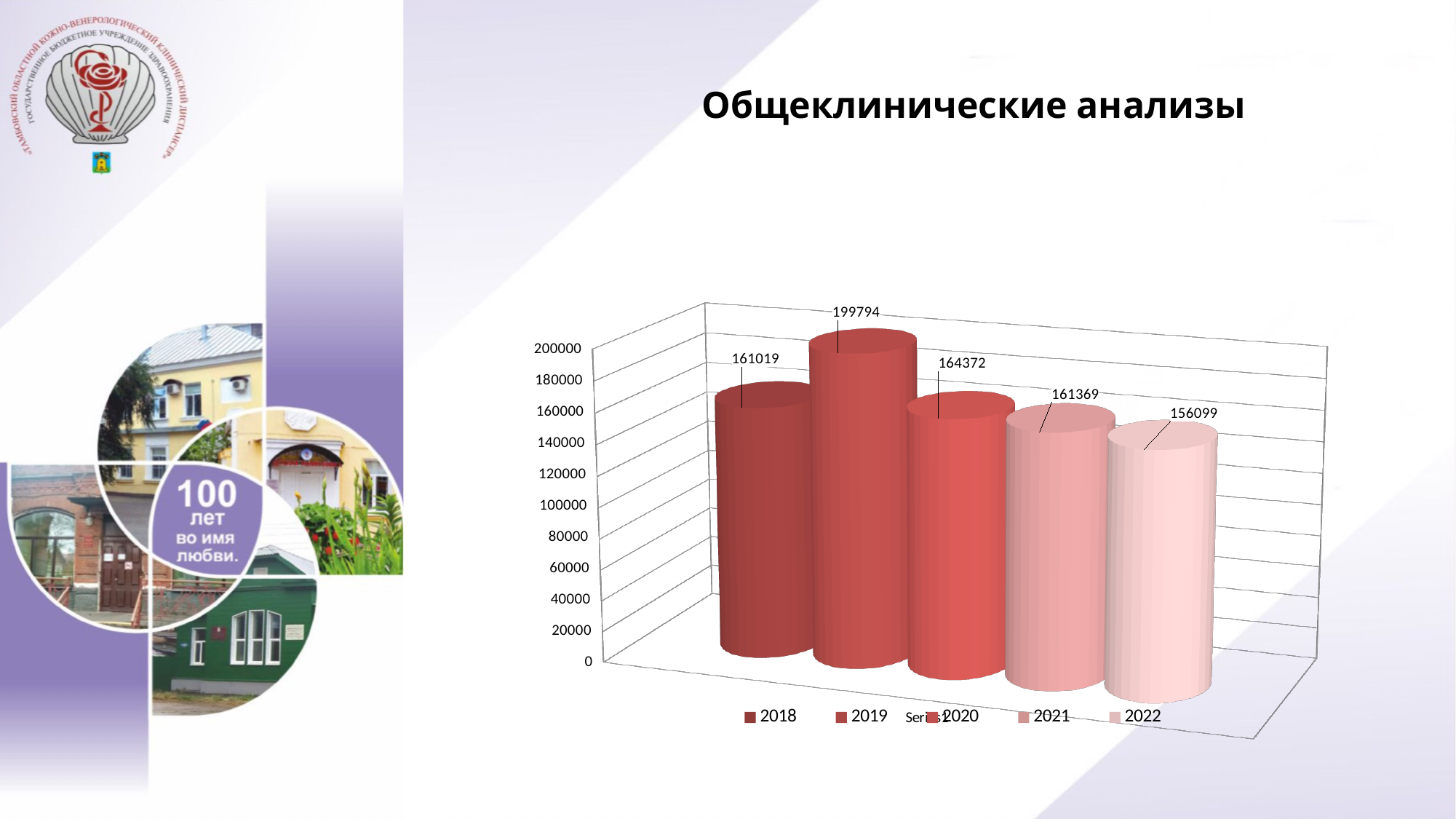
What is the value for 2019? 199794 Which year has the highest value? 2019 What kind of chart is shown on the slide? bar chart Which is larger, the value for 2020 or the value for 2022? 2020 What is the value for 2020? 164372 What is the value for 2022? 156099 How many years are shown in the chart? 5 What is the value for 2021? 161369 What is the value for 2018? 161019 What is the difference between the values for 2019 and 2018? 38775 Which year has the lowest value? 2022 What is the title of the chart? Общеклинические анализы